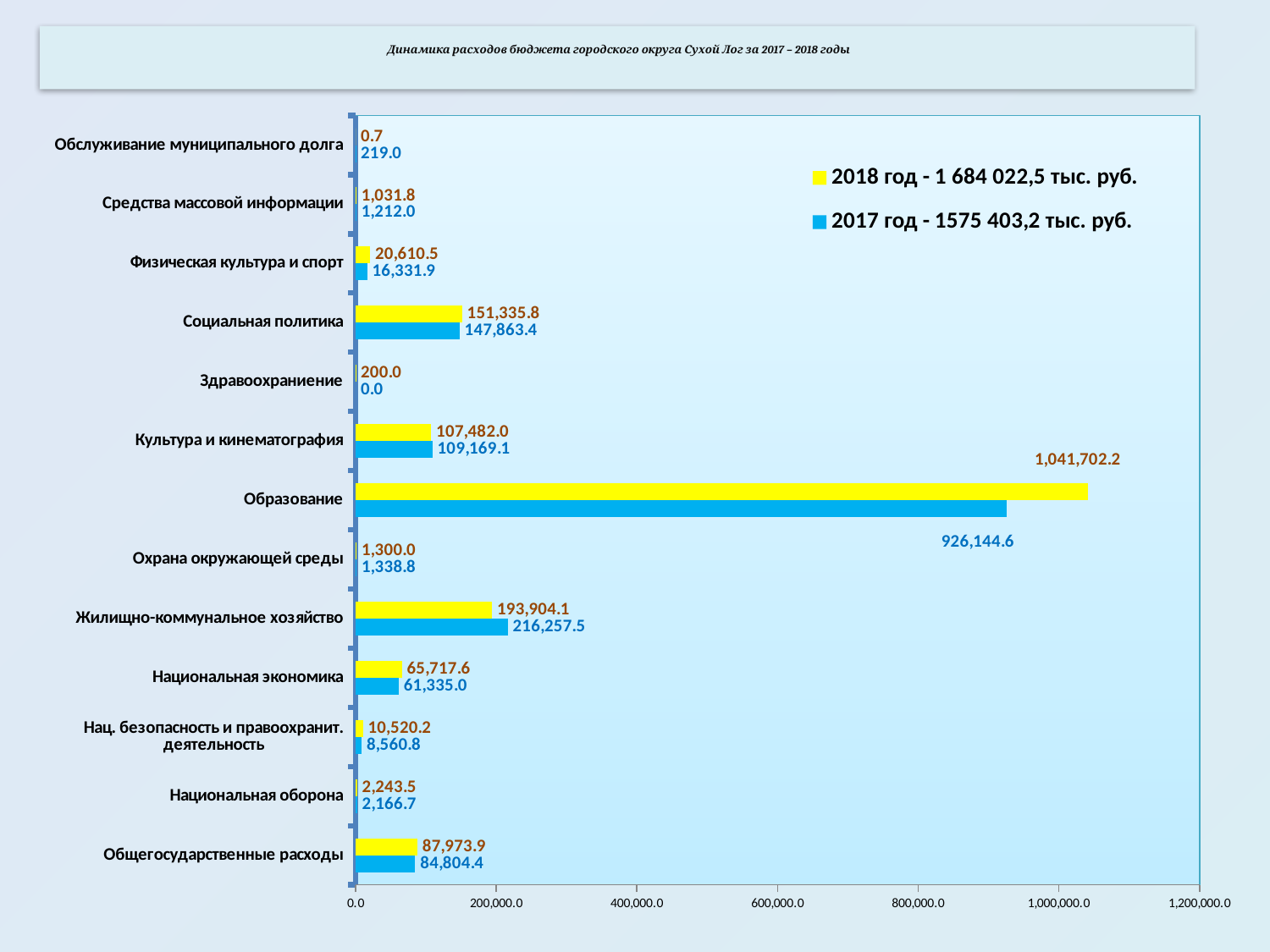
What type of chart is shown on the slide? bar chart Which category has the lowest 2018 value? Обслуживание муниципального долга What is the difference between the 2018 and 2017 values for Образование? 115,557.6 How many series does the legend list? 2 What is the 2017 value for Здравоохранение? 0.0 Which colour represents the 2018 series in the legend? yellow Which is larger for Жилищно-коммунальное хозяйство: the 2018 value or the 2017 value? 2017 Which category has the highest 2017 value? Образование What is the 2018 value for Социальная политика? 151,335.8 How many categories are shown on the chart? 13 What is the 2018 value for Образование? 1,041,702.2 What is the 2017 value for Жилищно-коммунальное хозяйство? 216,257.5